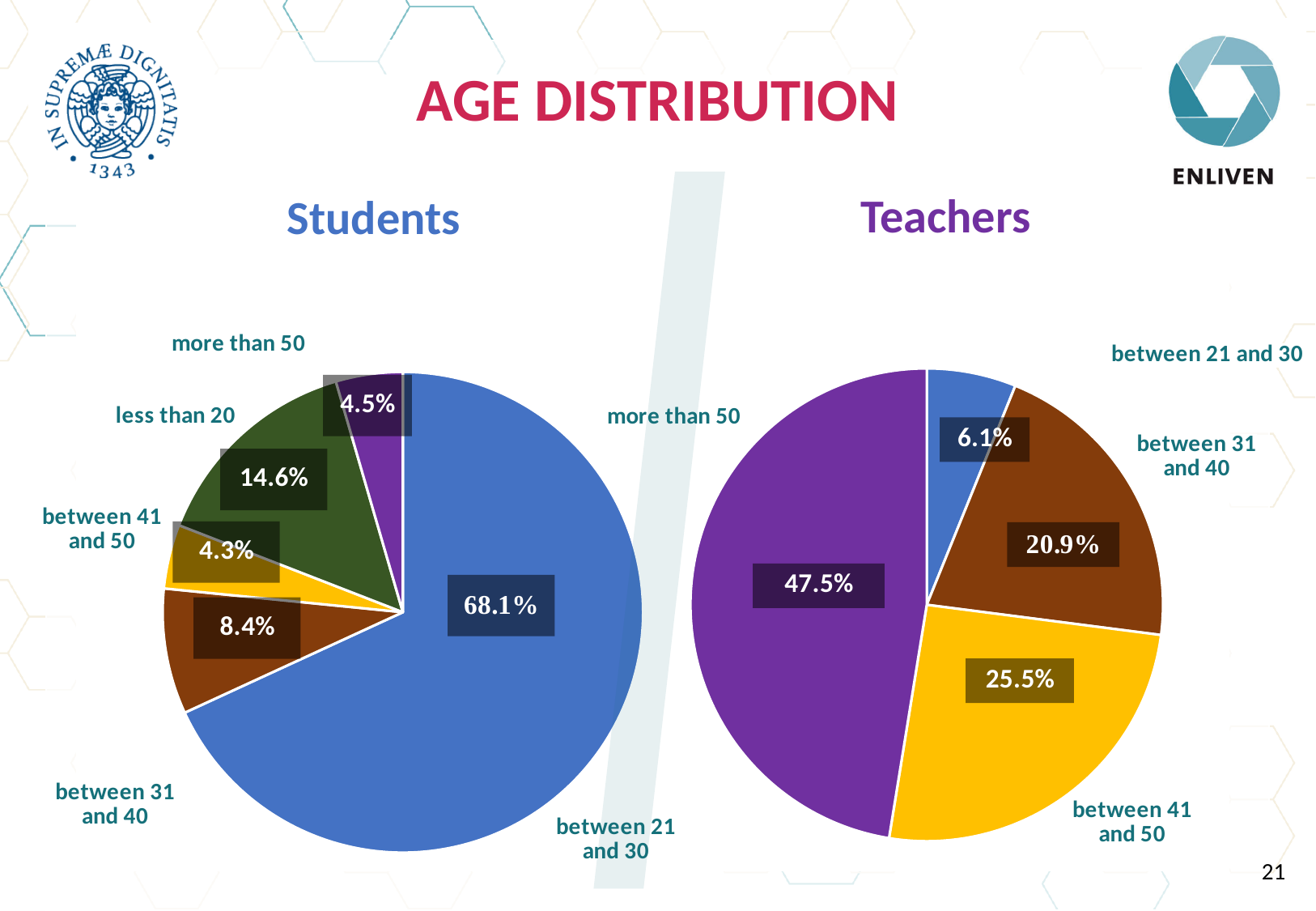
In the Teachers pie chart, what is the difference between the share of teachers between 41 and 50 and the share between 31 and 40? 4.6% In the Students pie chart, what share of students are between 21 and 30? 68.1% In the Teachers pie chart, what share of teachers are more than 50? 47.5% In the Students pie chart, which age group has the smallest share? between 41 and 50 Which is larger: the share of students between 21 and 30 or the share of teachers between 21 and 30? students between 21 and 30 In the Teachers pie chart, what percentage of teachers are between 31 and 40? 20.9% In the Students pie chart, what percentage of students are less than 20? 14.6% In the Students pie chart, what is the difference between the share of students between 31 and 40 and the share between 41 and 50? 4.1% How many age groups are shown in the Students pie chart? 5 What type of chart is used for the Teachers age distribution? pie chart In the Teachers pie chart, which age group has the largest share? more than 50 In the Teachers pie chart, which age group has the smallest share? between 21 and 30